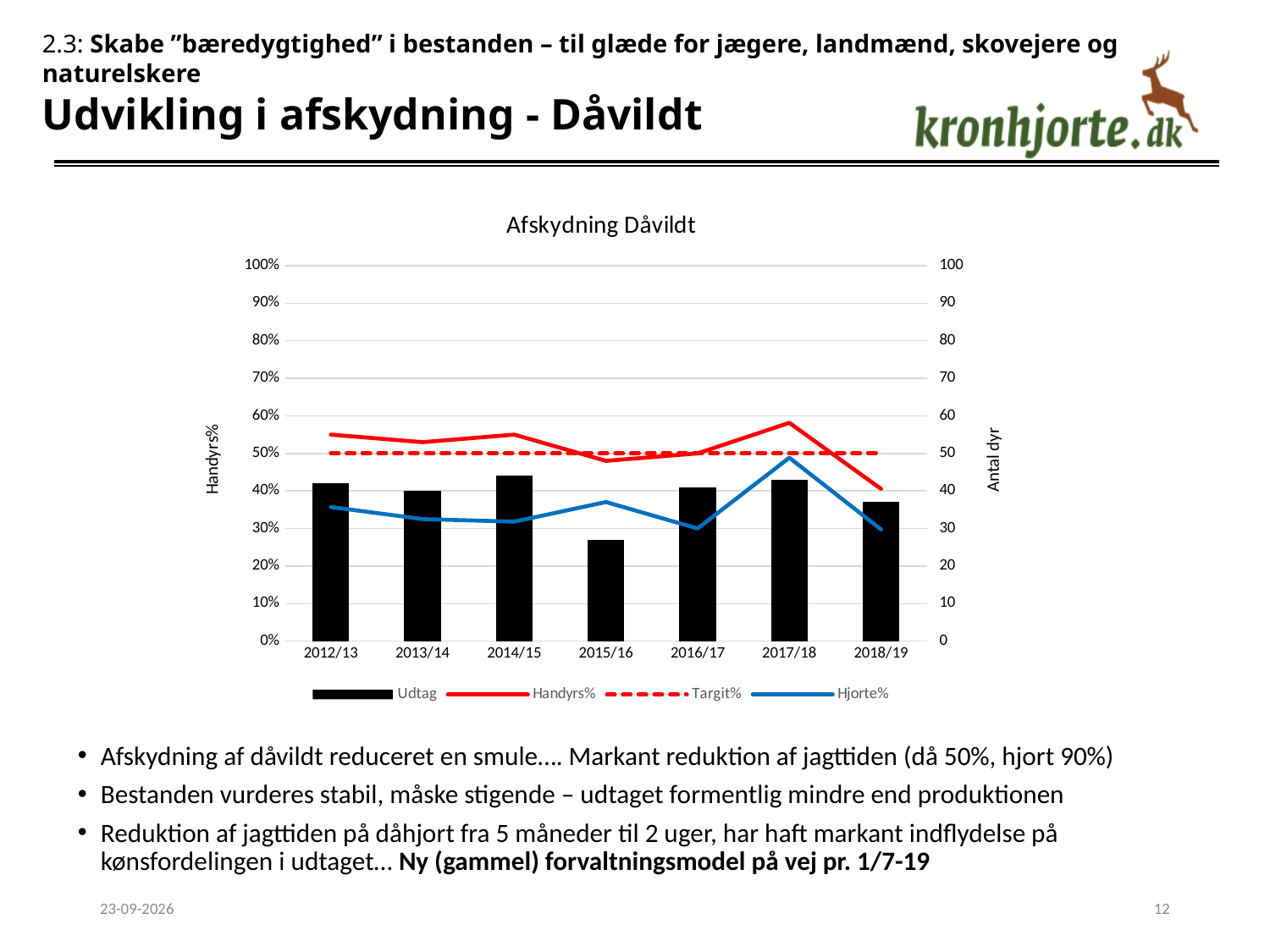
What is the title of the chart? Afskydning Dåvildt How many series does the chart legend list? 4 Is the Hjorte% value for 2016/17 greater or less than 40%? less In 2012/13, which is larger: Handyrs% or Hjorte%? Handyrs% What kind of chart is shown on the slide? Combined bar and line chart In which season does the Handyrs% line reach its highest point? 2017/18 Which season has the lowest Udtag bar? 2015/16 Is the Udtag value for 2015/16 greater or less than 30? less What constant value does the Targit% line show? 50% Does the Handyrs% line rise or fall from 2017/18 to 2018/19? fall How many seasons are shown on the x axis of the chart? 7 Is the Handyrs% value for 2017/18 greater or less than 50%? greater